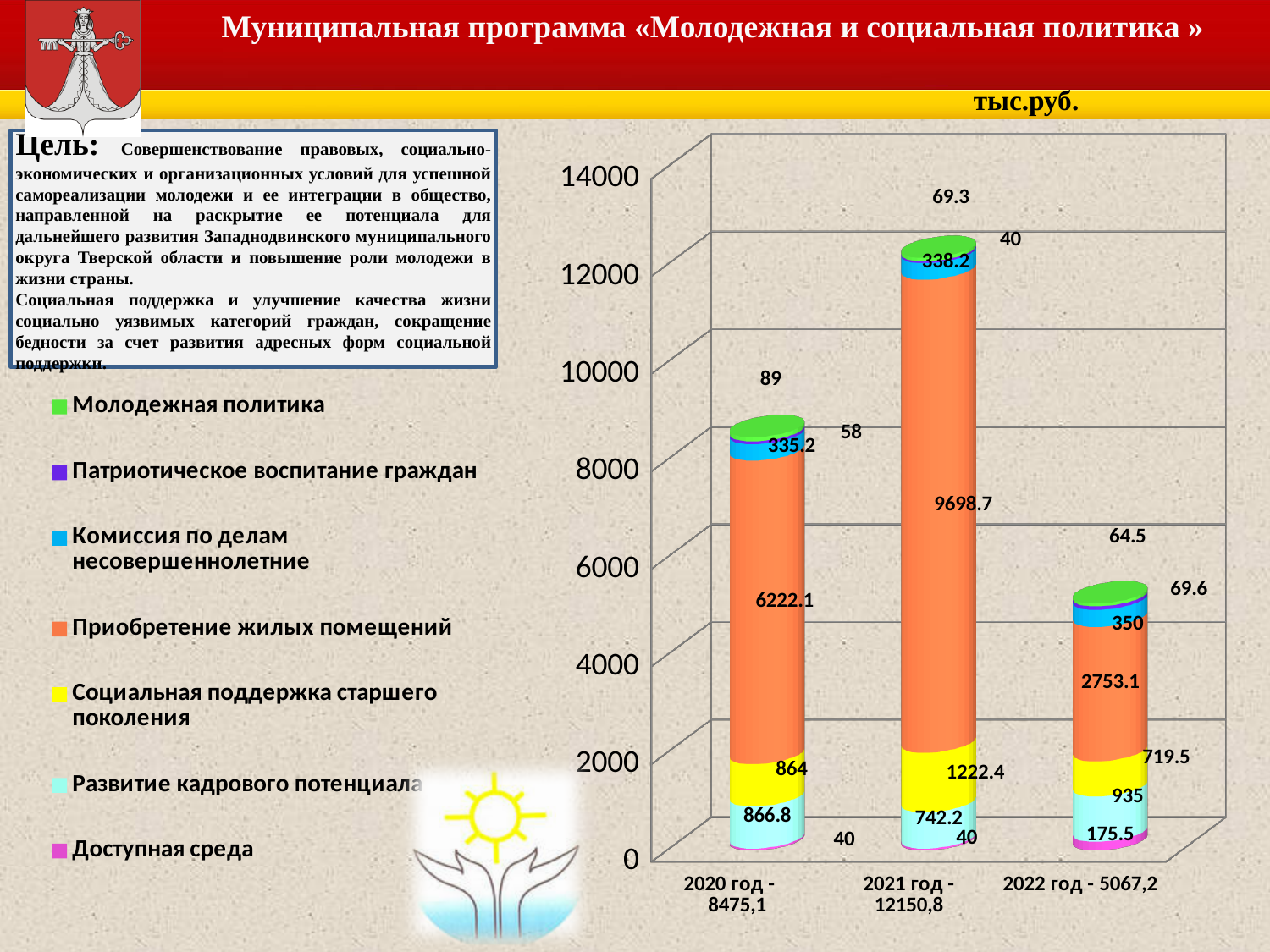
What is the value for Приобретение жилых помещений in 2021? 9698.7 How many series does the chart legend list? 7 How many years (categories) are shown on the x axis of the chart? 3 What is the difference between the Приобретение жилых помещений values for 2021 and 2020? 3476.6 What is the value for Социальная поддержка старшего поколения in 2022? 719.5 What is the value for Развитие кадрового потенциала in 2020? 866.8 What is the total of the stacked bar for 2021, as shown in its category label? 12150,8 In which year is the value for Приобретение жилых помещений the highest? 2021 Which is larger: Социальная поддержка старшего поколения in 2021 or in 2020? 2021 What is the value for Приобретение жилых помещений in 2020? 6222.1 In what units are the chart values given, according to the label above the chart? тыс.руб. What kind of chart is shown on the slide? bar chart